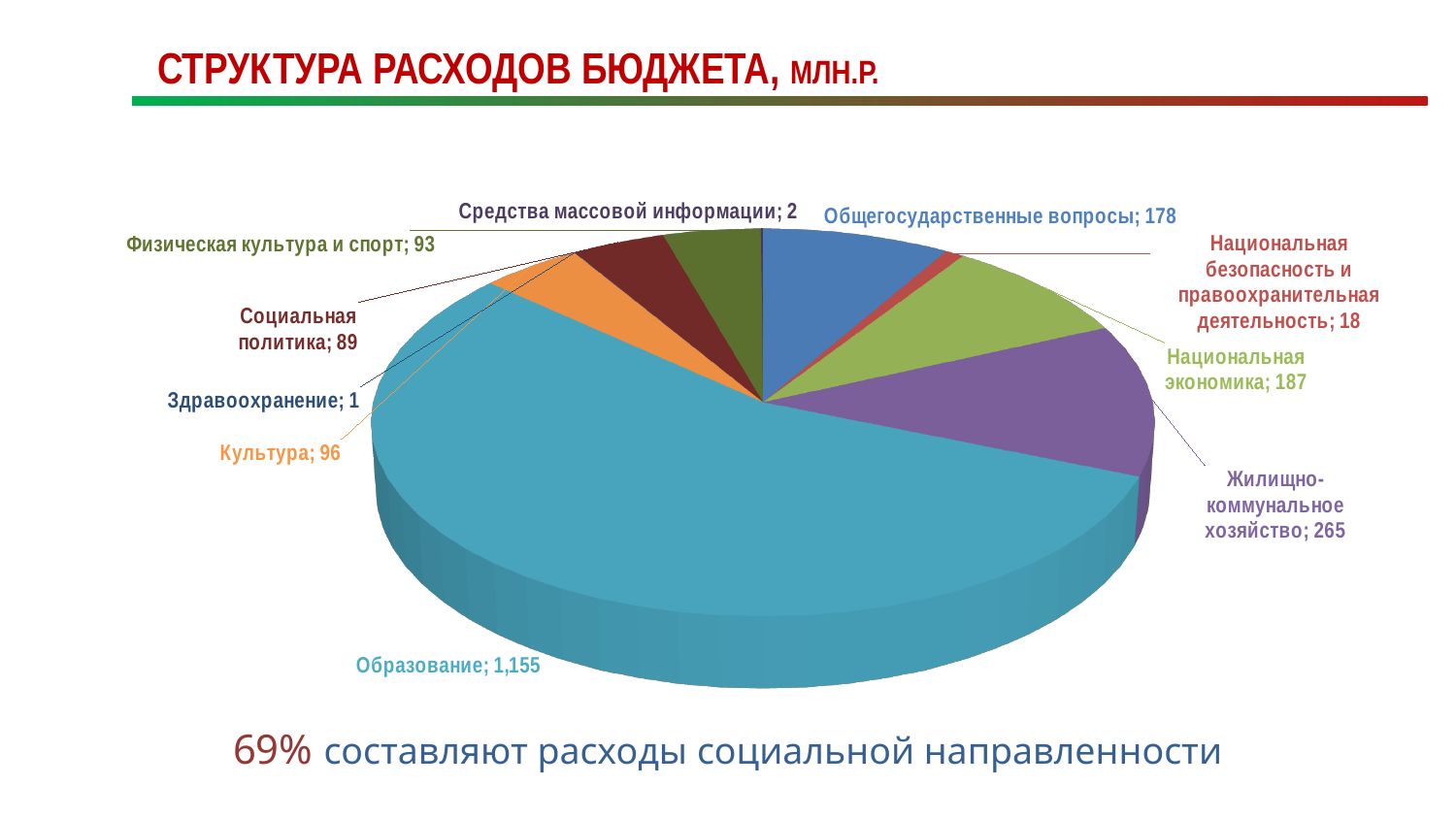
How many categories are shown in the pie chart? 10 Which category has the highest value? Образование What is the difference between the values for Жилищно-коммунальное хозяйство and Национальная экономика? 78 What is the title of the chart? СТРУКТУРА РАСХОДОВ БЮДЖЕТА, МЛН.Р. Which category has the lowest value? Здравоохранение What is the value for Образование? 1,155 Which is larger, the value for Общегосударственные вопросы or the value for Национальная экономика? Национальная экономика What is the difference between the values for Культура and Социальная политика? 7 What is the value for Культура? 96 What is the value for Жилищно-коммунальное хозяйство? 265 What is the value for Национальная безопасность и правоохранительная деятельность? 18 What kind of chart is shown on the slide? Pie chart